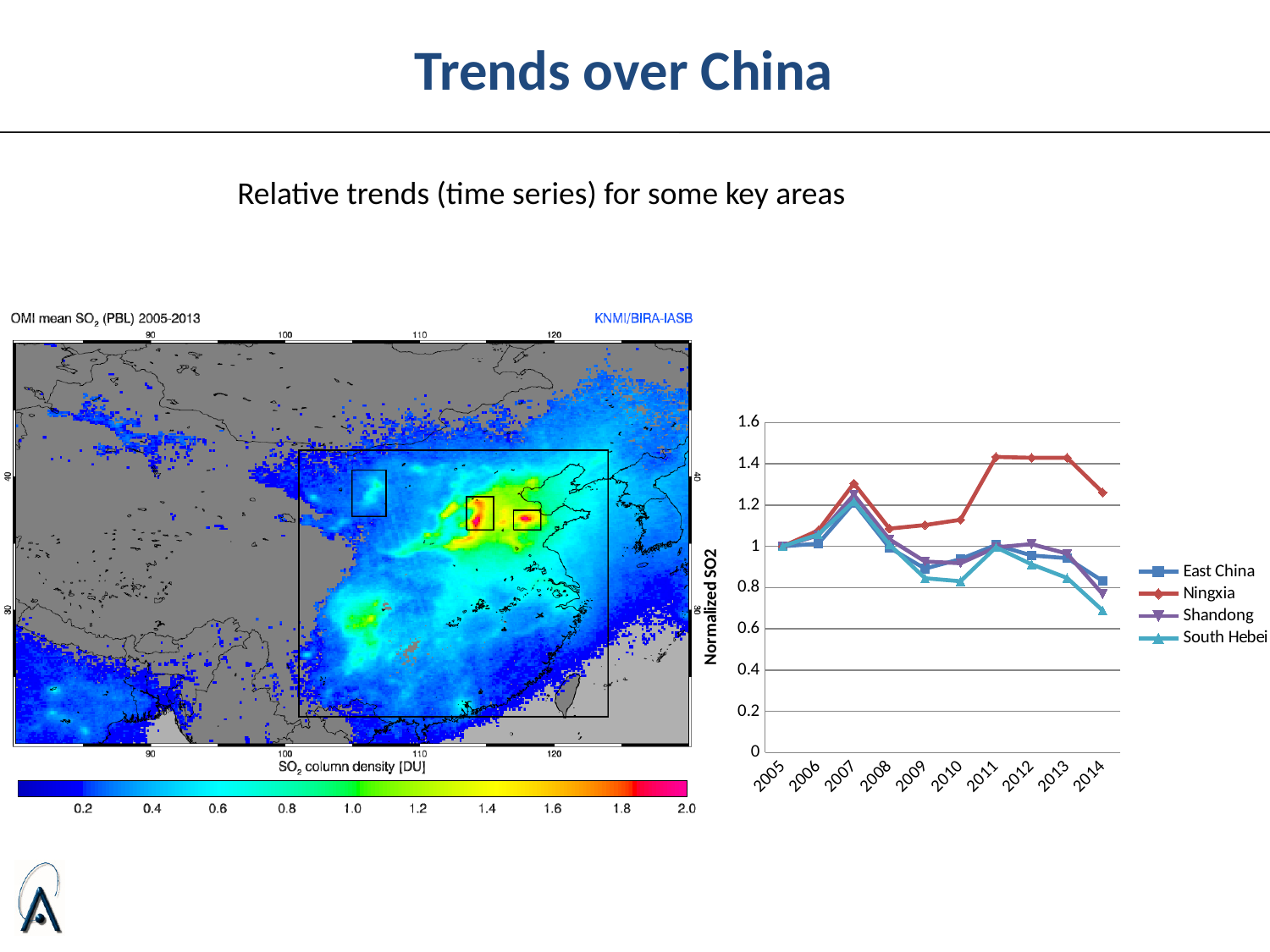
In the line chart, does the Ningxia series rise or fall from 2013 to 2014? fall How many years are shown along the x axis of the line chart? 10 How many series does the legend of the line chart list? 4 In the line chart, is the value for Ningxia in 2011 greater or less than 1.4? greater In the line chart, is the value for Ningxia in 2014 greater or less than 1.2? greater In the line chart, is the value for South Hebei in 2014 greater or less than 0.8? less In the line chart, which series has the highest value in 2013? Ningxia In the line chart, what is the value for Ningxia in 2005? 1 What kind of chart is shown on the right side of the slide? line chart In the line chart, which is larger in 2012: the value for Ningxia or the value for East China? Ningxia In the line chart, which series has the lowest value in 2014? South Hebei What is the label on the y axis of the line chart? Normalized SO2